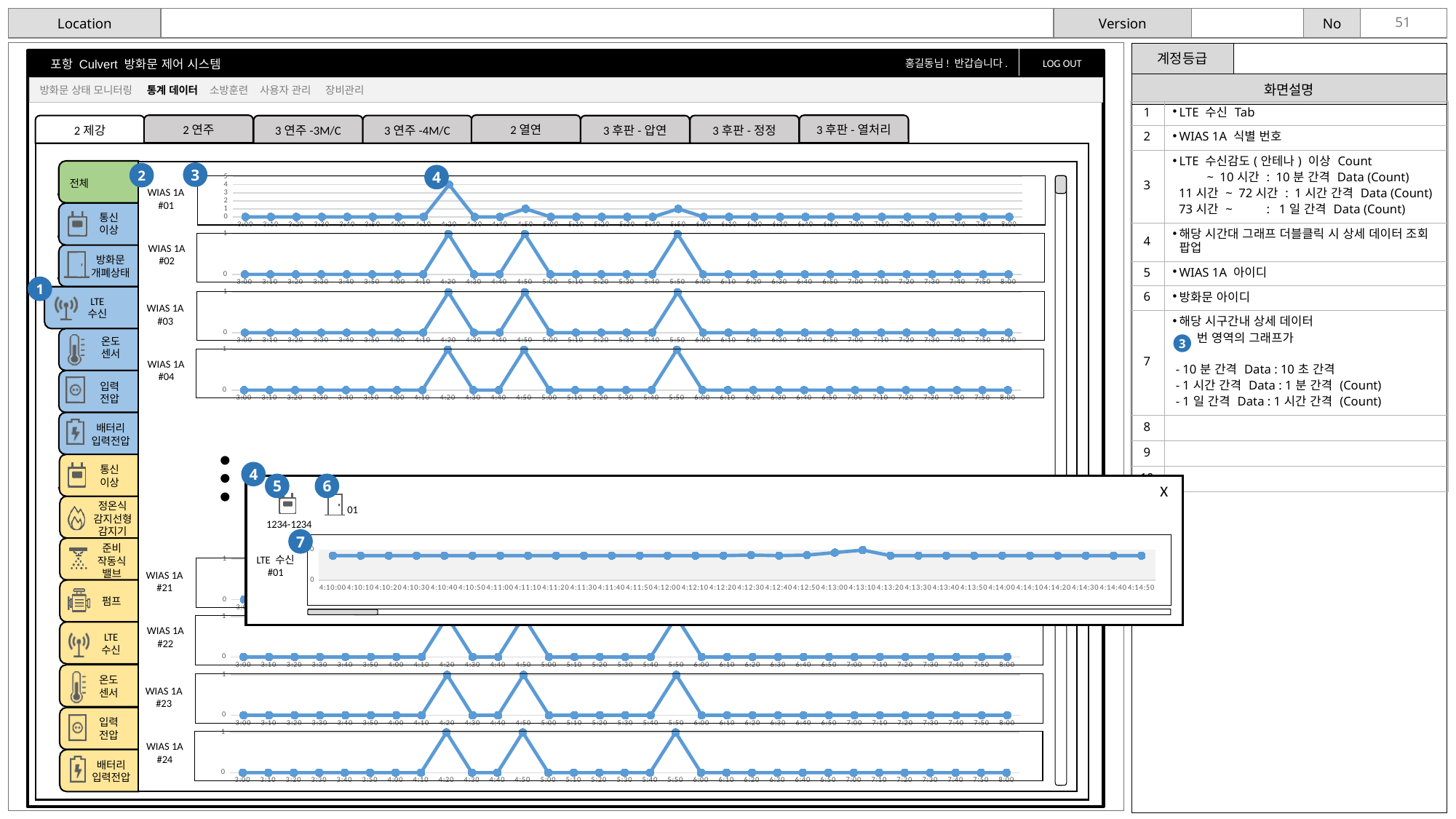
What kind of chart is the WIAS 1A #02 chart? line chart On the WIAS 1A #01 chart, at which time is the value highest? 4:20 On the WIAS 1A #24 chart, what is the value at 5:50? 1 On the WIAS 1A #02 chart, what is the value at 4:20? 1 On the WIAS 1A #03 chart, what is the value at 3:00? 0 What is the highest y-axis tick on the WIAS 1A #01 chart? 5 How many time points are plotted on the WIAS 1A #04 chart? 31 What are the first and last x-axis labels on the WIAS 1A #04 chart? 3:00 and 8:00 On the WIAS 1A #01 chart, is the value at 4:20 greater or less than 3? greater What kind of chart is shown in the popup labelled LTE 수신 #01? line chart On the WIAS 1A #01 chart, which is larger, the value at 4:20 or the value at 4:50? 4:20 On the WIAS 1A #22 chart, what is the value at 6:00? 0